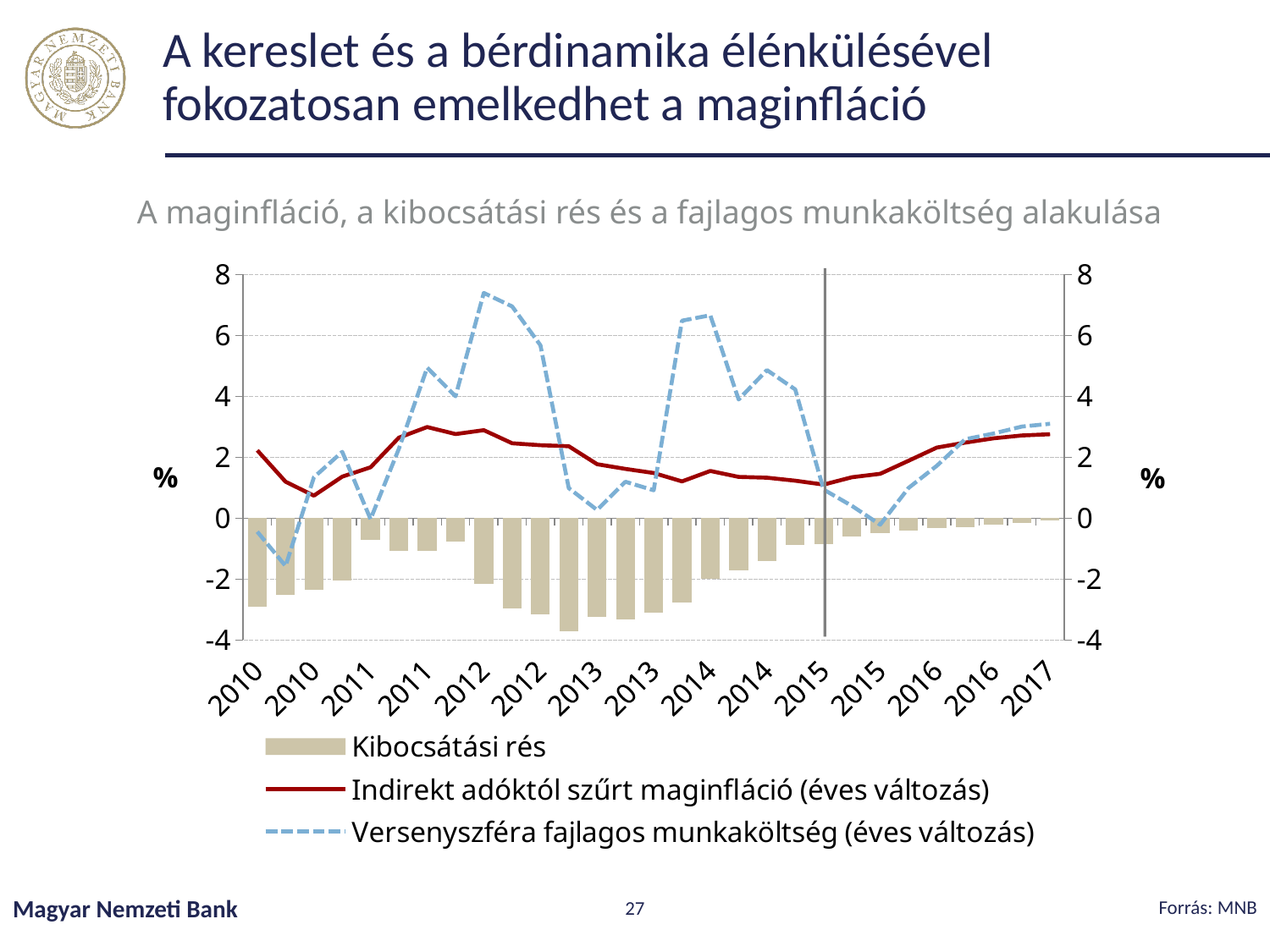
Does the Indirekt adóktól szűrt maginfláció (éves változás) line rise or fall from 2015 to 2017? rise Is the lowest Kibocsátási rés bar, in 2013, greater or less than -2? less Is the value of Indirekt adóktól szűrt maginfláció (éves változás) at the end of 2011 greater or less than 2? greater How many series does the legend list? 3 Is the value of Indirekt adóktól szűrt maginfláció (éves változás) at the 2015 vertical line greater or less than 2? less Which series reaches the highest value on the chart, Indirekt adóktól szűrt maginfláció (éves változás) or Versenyszféra fajlagos munkaköltség (éves változás)? Versenyszféra fajlagos munkaköltség (éves változás) Does the Versenyszféra fajlagos munkaköltség (éves változás) line rise or fall from early 2014 to 2015? fall What kind of chart is shown on the slide? A combined bar and line chart What is the title of the chart? A maginfláció, a kibocsátási rés és a fajlagos munkaköltség alakulása Which series is shown as bars in the chart? Kibocsátási rés